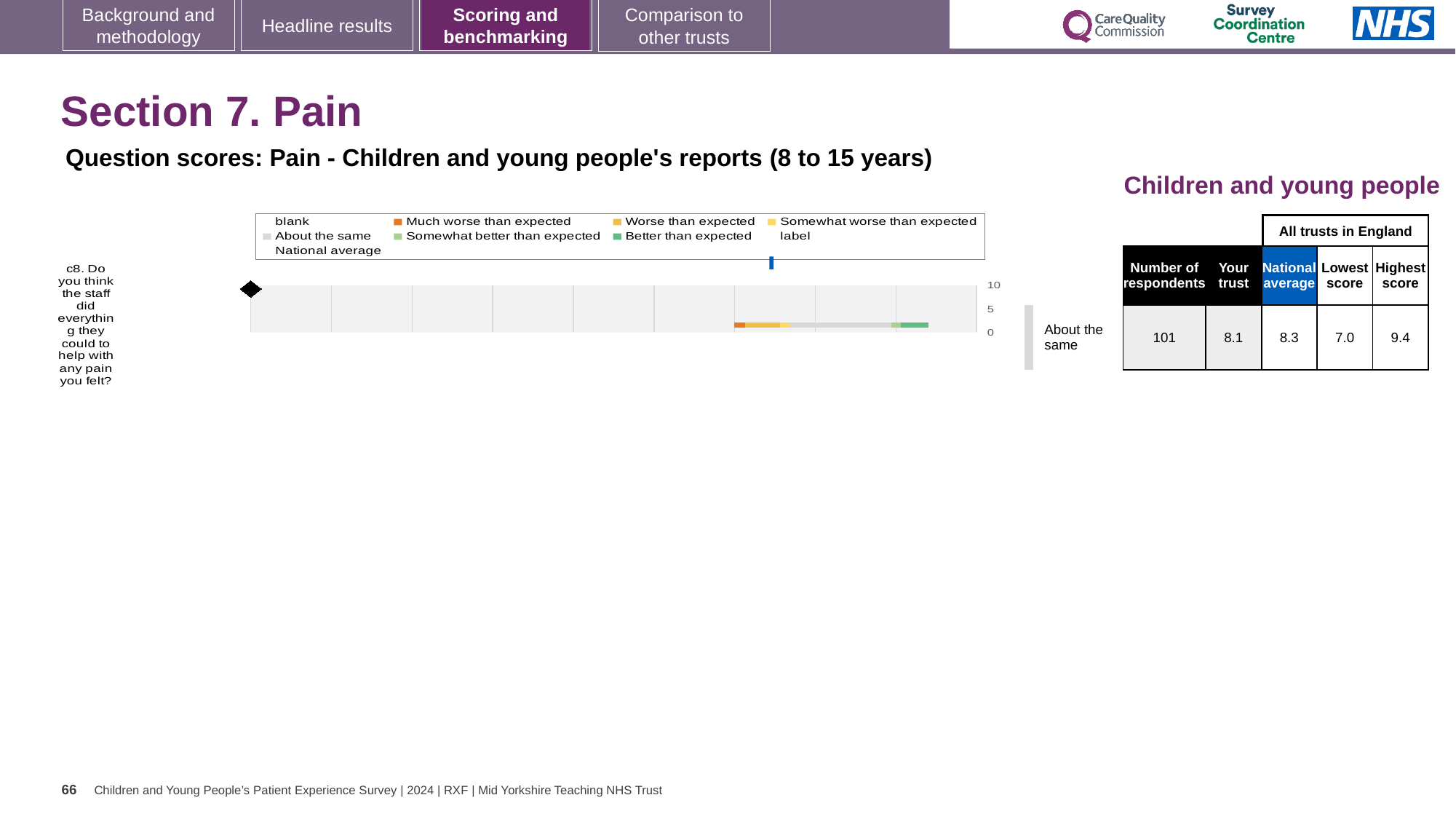
What benchmark category is the trust's result for question c8 labelled as next to the chart? About the same What is the highest value shown on the chart's score axis? 10 What is the difference between the highest and lowest scores for question c8? 2.4 Which is larger for question c8, the 'Your trust' score or the national average? National average What is the highest score among all trusts in England for question c8? 9.4 What is the lowest score among all trusts in England for question c8? 7.0 How many respondents answered question c8? 101 Is the 'Your trust' score for question c8 greater or less than 5 on the chart's axis? greater What is the 'Your trust' score for question c8 shown alongside the chart? 8.1 What kind of chart is used to show the question score for c8? bar chart How many questions are plotted in the chart? 1 What is the national average score for question c8? 8.3